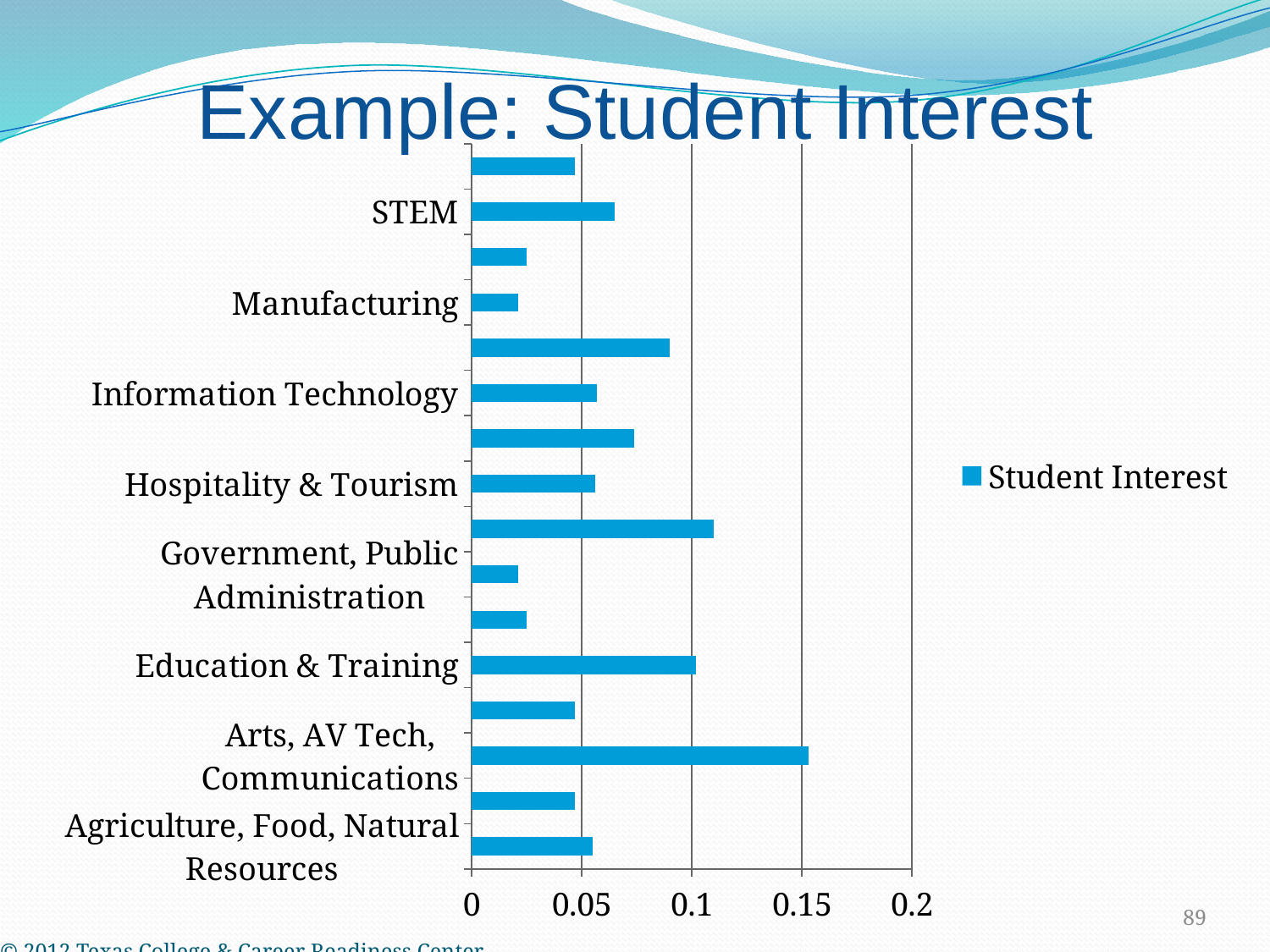
Is the Student Interest value for Government, Public Administration greater or less than 0.05? less How many series does the legend list? 1 How many bars are plotted in the chart? 16 Which labeled category has the highest Student Interest value? Arts, AV Tech, Communications Is the Student Interest value for Manufacturing greater or less than 0.05? less What is the title of the slide containing the chart? Example: Student Interest Is the Student Interest value for Education & Training greater or less than 0.05? greater What is the legend entry for the series in the chart? Student Interest Which has a larger Student Interest value, Education & Training or Manufacturing? Education & Training What kind of chart is shown on the slide? bar chart